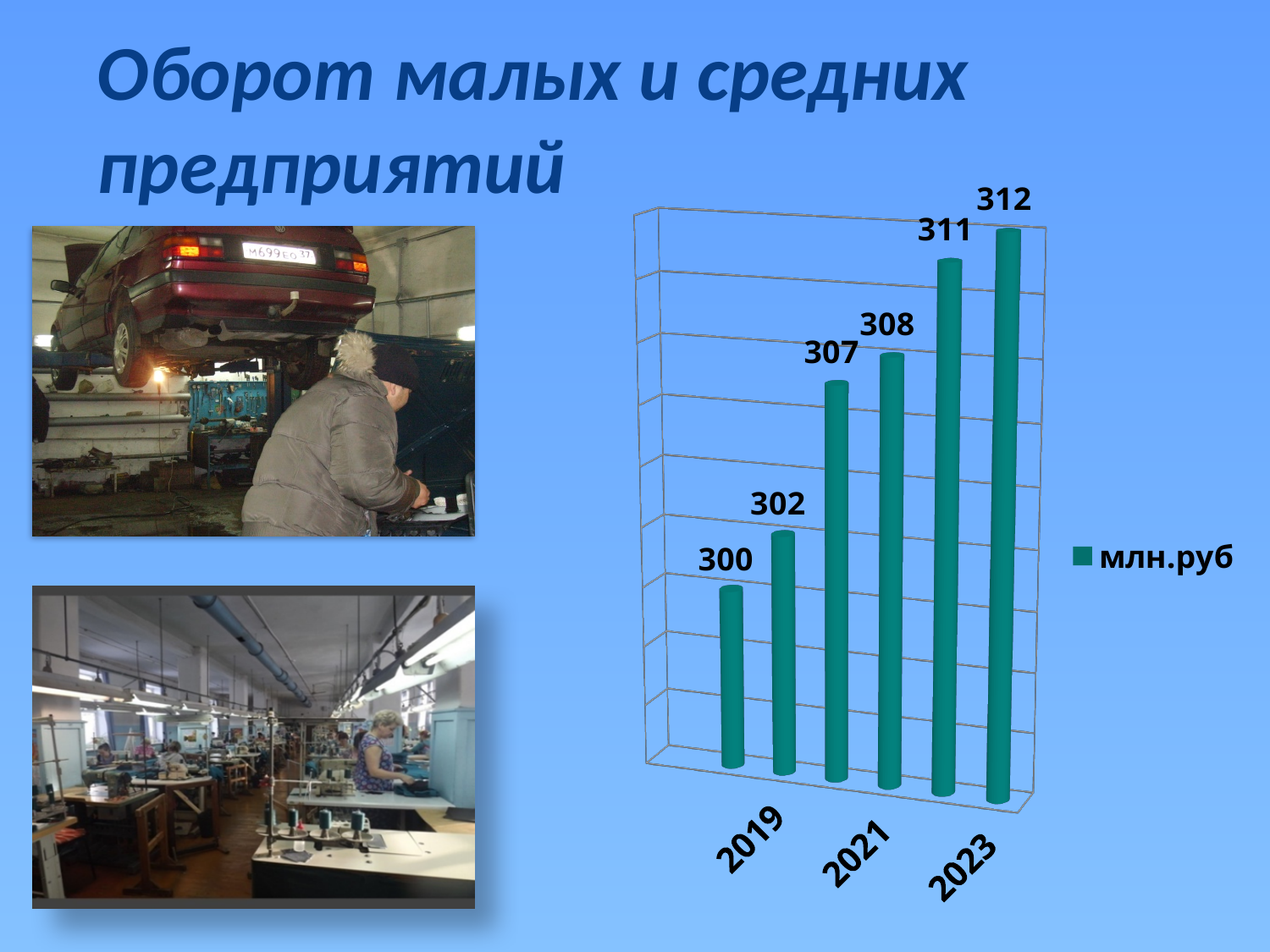
What is the value for 2023? 312 What is the value for 2019? 302 Which is larger, the value for 2021 or the value for 2019? 2021 How many bars are plotted in the chart? 6 What is the difference between the values for 2021 and 2019? 6 What is the value for 2021? 308 What is the difference between the values for 2023 and 2019? 10 What is the value of the shortest bar in the chart? 300 What is the value of the tallest bar in the chart? 312 What kind of chart is shown on the slide? bar chart How many series does the legend list? 1 Do the values rise or fall from left to right along the x axis? rise